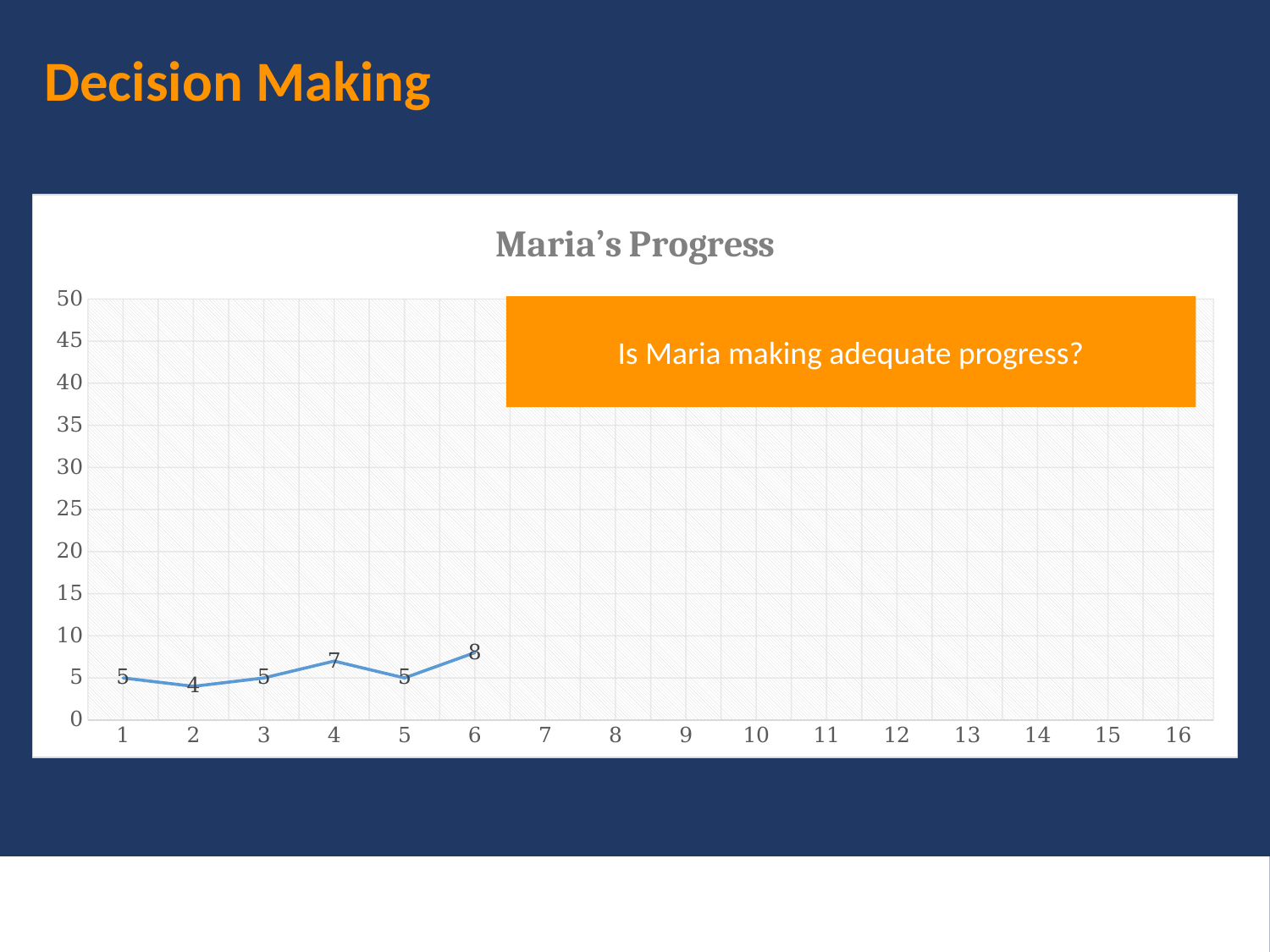
What is the value at point 4? 7 At which point is the value lowest? 2 What is the value at point 6? 8 At which point is the value highest? 6 What is the value at point 1? 5 What is the value at point 2? 4 Which is larger, the value at point 4 or the value at point 5? point 4 What is the title of the chart? Maria's Progress How many data points are plotted on the line? 6 What is the difference between the values at point 6 and point 2? 4 What kind of chart is shown on the slide? line chart Is the value at point 6 greater or less than 10? less